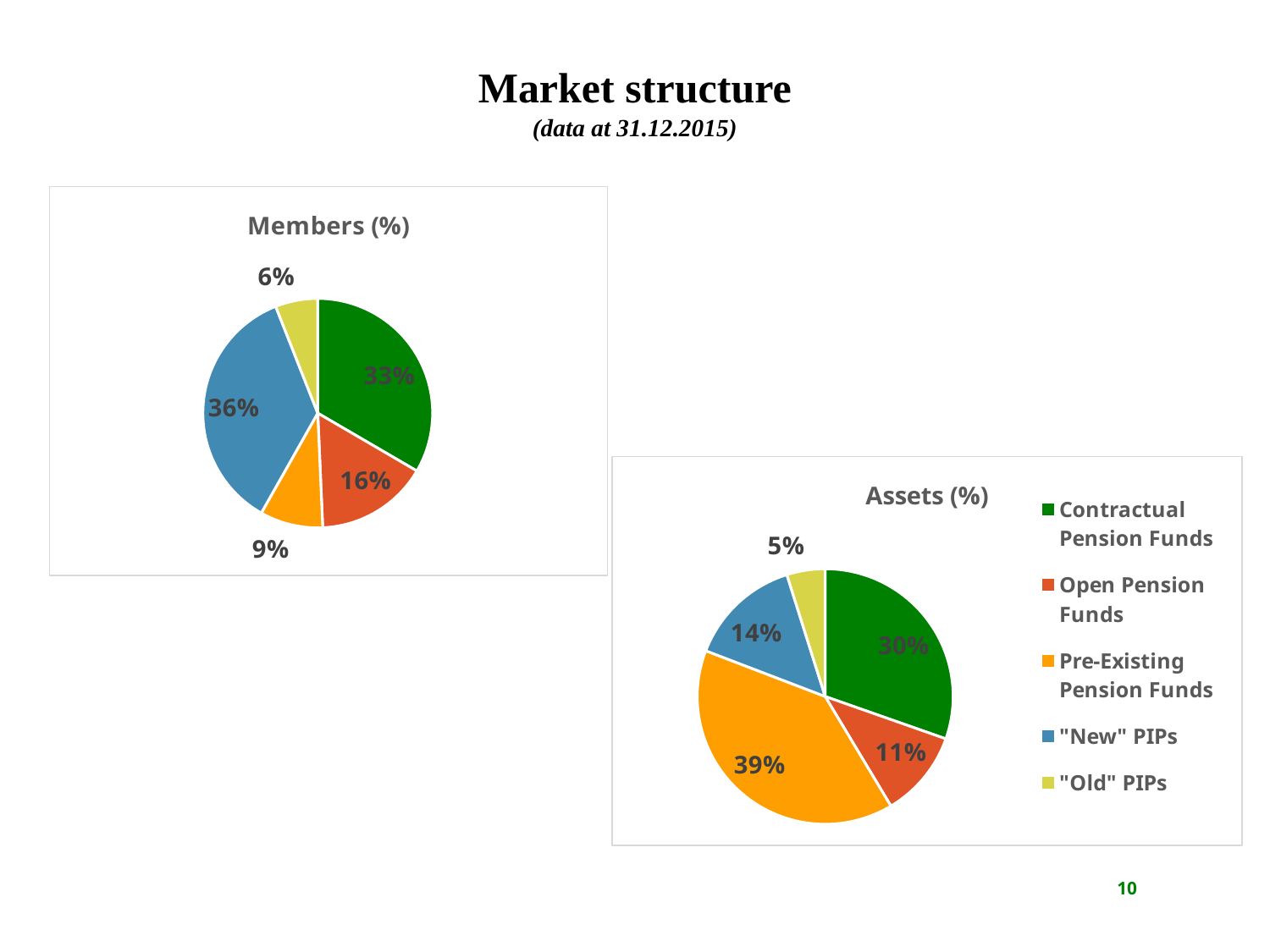
What type of chart is the Members (%) chart? Pie chart In the Members (%) chart, what share do "New" PIPs have? 36% In the Assets (%) chart, what share do Open Pension Funds have? 11% In the Assets (%) chart, what share do Pre-Existing Pension Funds have? 39% In the Members (%) chart, which category has the largest share? "New" PIPs Which is larger: the share of Pre-Existing Pension Funds in the Members (%) chart or in the Assets (%) chart? Assets (%) In the Assets (%) chart, which category has the smallest share? "Old" PIPs In the Members (%) chart, what is the difference between the shares of Contractual Pension Funds and Open Pension Funds? 17 percentage points In the Assets (%) chart, which category has the largest share? Pre-Existing Pension Funds How many slices does the Assets (%) pie chart have? 5 How many entries does the legend on the Assets (%) chart list? 5 In the Assets (%) chart, which colour represents Contractual Pension Funds? Green